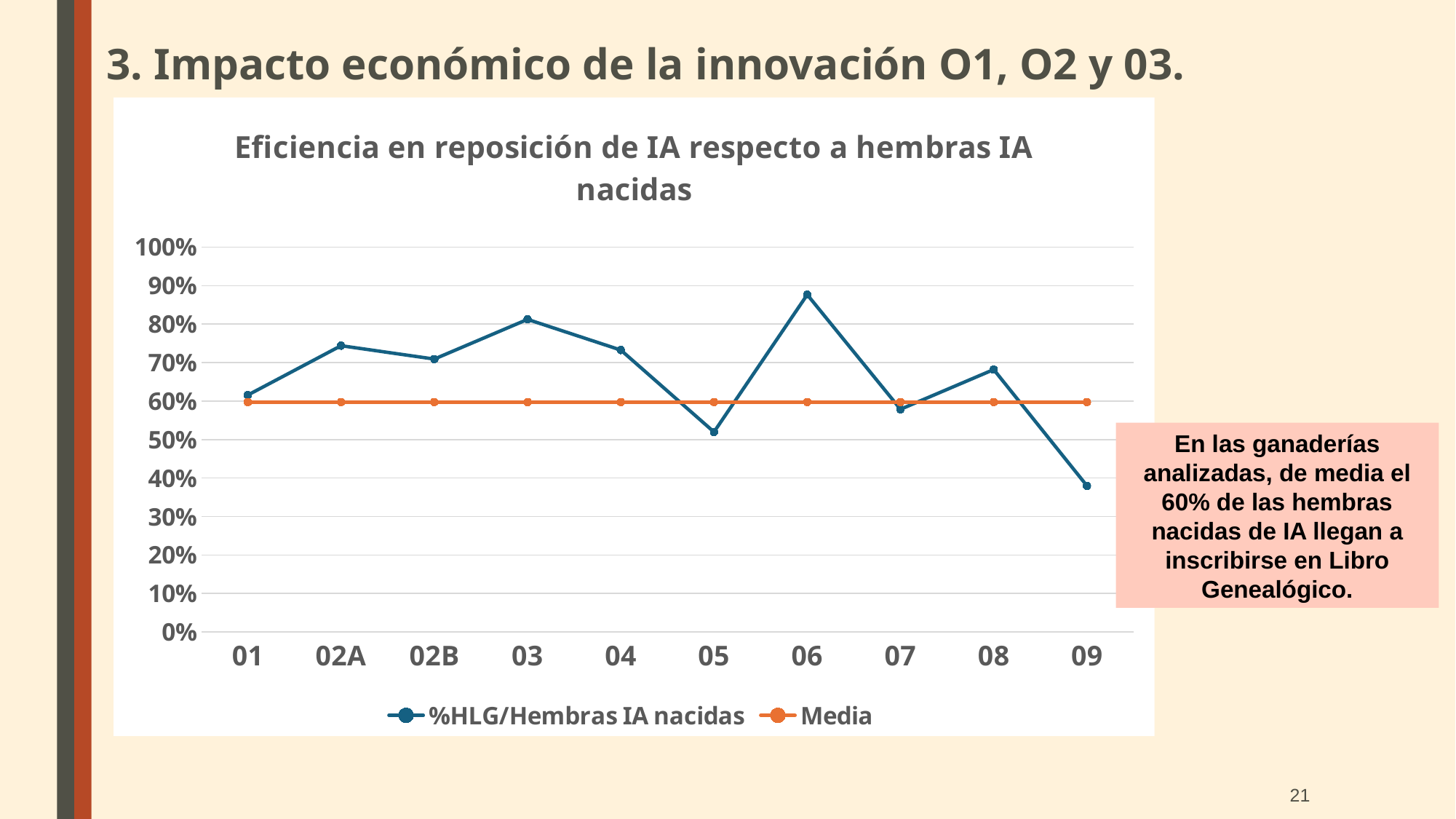
Is the value for %HLG/Hembras IA nacidas at 02A greater or less than 70%? greater Which category has the highest value for %HLG/Hembras IA nacidas? 06 Is the value for %HLG/Hembras IA nacidas at 05 greater or less than 60%? less How many series does the legend list? 2 What kind of chart is shown on the slide? line chart Which category has the lowest value for %HLG/Hembras IA nacidas? 09 Which is larger for %HLG/Hembras IA nacidas, 03 or 04? 03 Is the value for %HLG/Hembras IA nacidas at 09 greater or less than 50%? less How many categories are shown on the x axis? 10 What is the title of the chart? Eficiencia en reposición de IA respecto a hembras IA nacidas Does the %HLG/Hembras IA nacidas line rise or fall from 03 to 05? fall